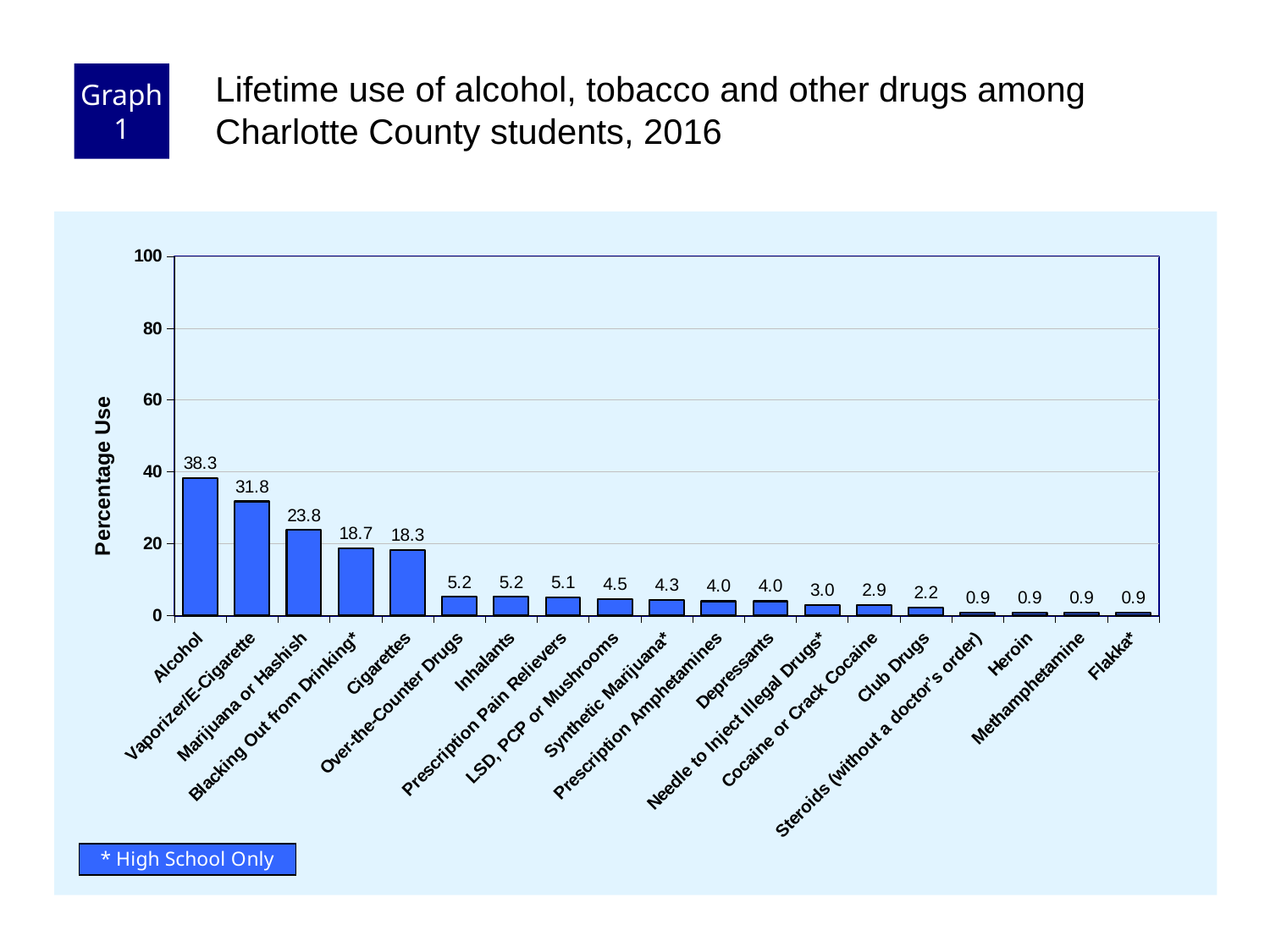
What is the percentage use for Alcohol? 38.3 What is the lowest percentage use value shown on the chart? 0.9 What is the difference in percentage use between Blacking Out from Drinking* and Cigarettes? 0.4 What is the percentage use for Club Drugs? 2.2 What is the difference in percentage use between Alcohol and Marijuana or Hashish? 14.5 What type of chart is shown on the slide? Bar chart What is the percentage use for Cigarettes? 18.3 How many categories are shown on the chart? 19 Which has a higher percentage use, Marijuana or Hashish or Cigarettes? Marijuana or Hashish Which category has the highest percentage use? Alcohol Is the value for Vaporizer/E-Cigarette greater or less than 20? greater What is the percentage use for Vaporizer/E-Cigarette? 31.8